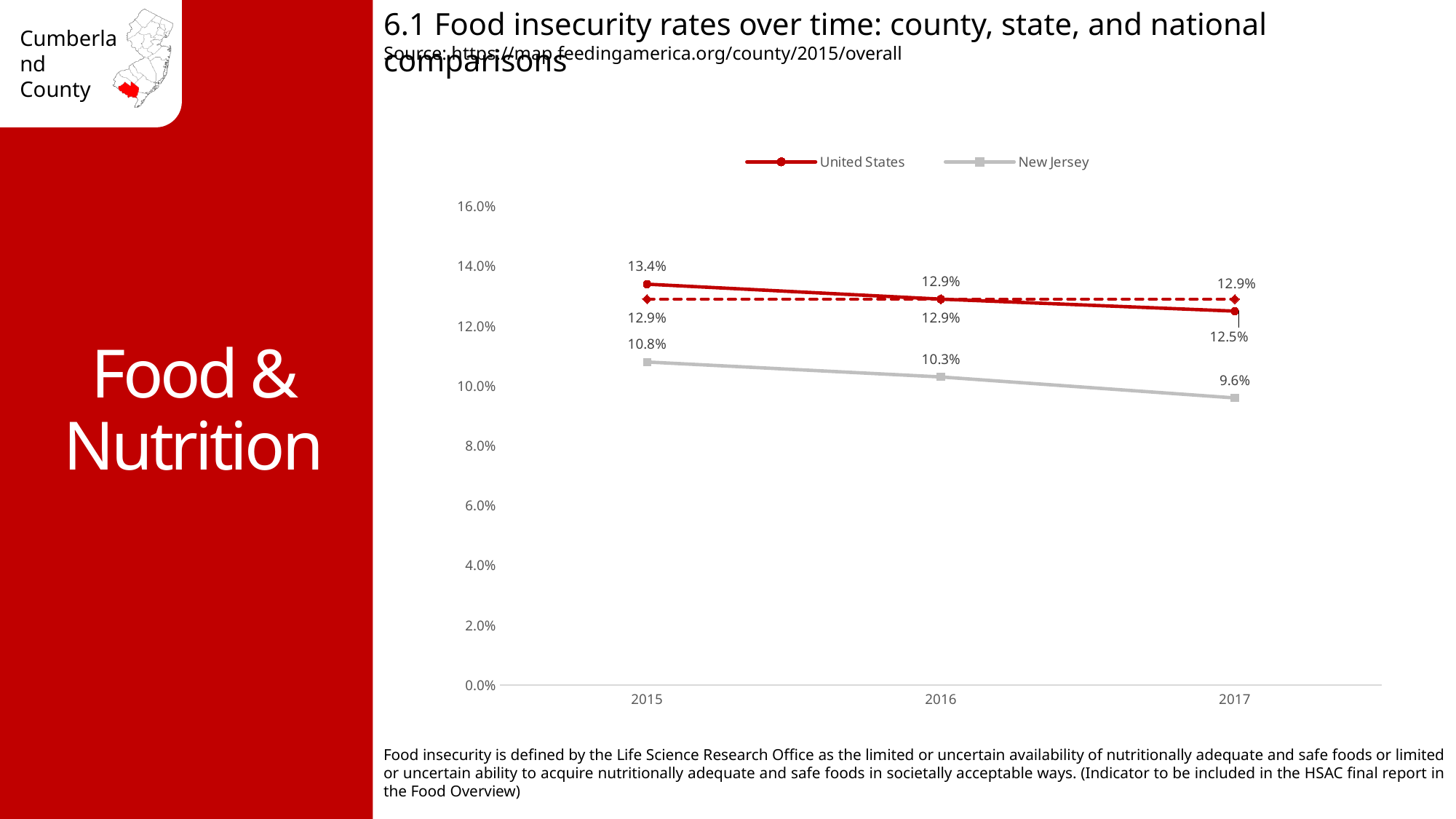
In which year was the United States food insecurity rate lowest? 2017 What was the food insecurity rate for New Jersey in 2016? 10.3% What was the food insecurity rate for New Jersey in 2017? 9.6% Does the New Jersey food insecurity rate rise or fall from 2015 to 2017? Fall In which year was the New Jersey food insecurity rate highest? 2015 Which had a higher food insecurity rate in 2016, the United States or New Jersey? United States What is the difference between the United States and New Jersey food insecurity rates in 2015? 2.6% How many series does the chart legend list? 2 How many years are shown on the x axis of the chart? 3 What was the food insecurity rate for the United States in 2015? 13.4% What was the food insecurity rate for the United States in 2017? 12.5% What kind of chart is shown on the slide? Line chart